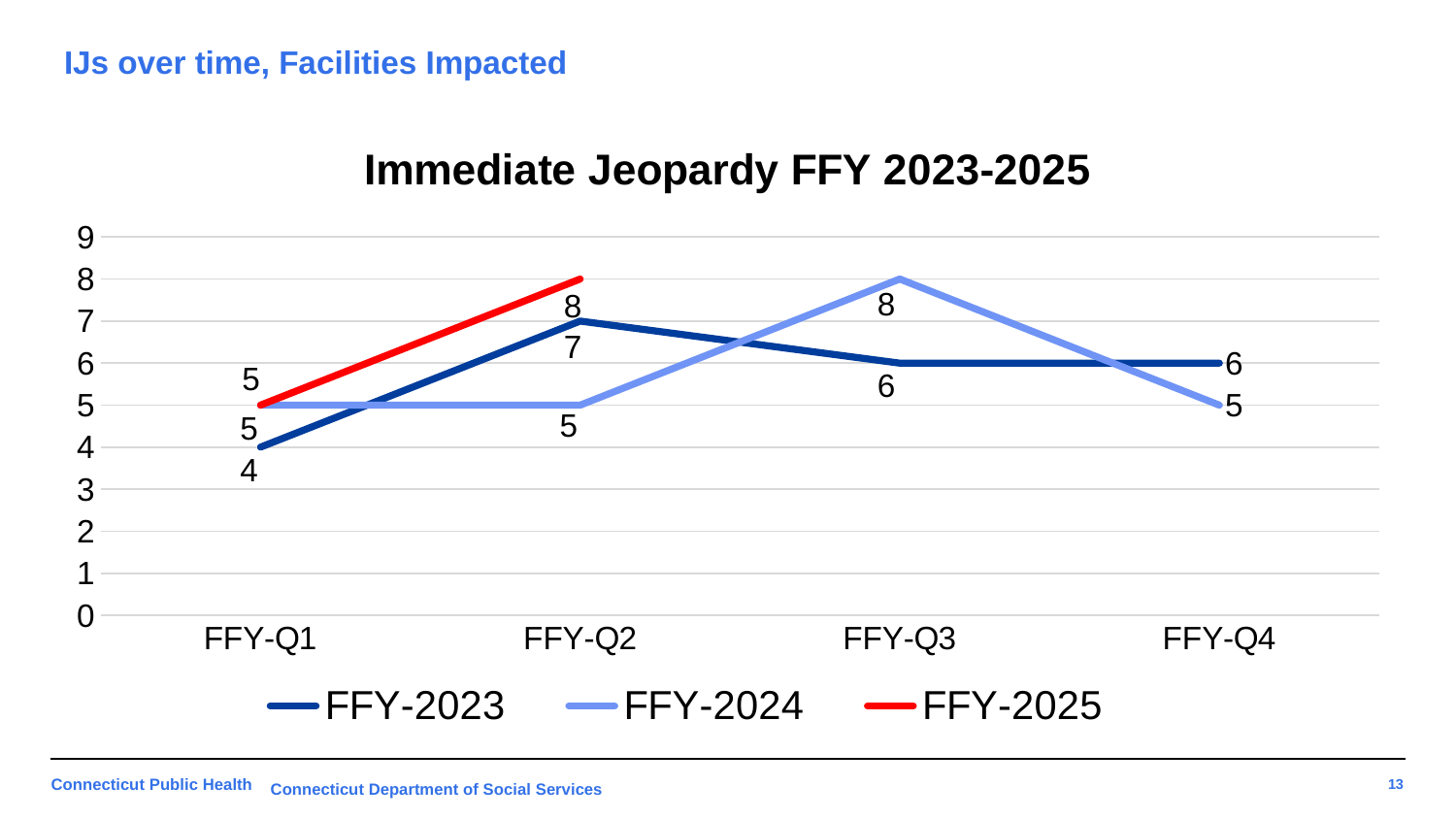
What is the value for FFY-2025 in FFY-Q2? 8 What is the difference between the FFY-2024 values in FFY-Q3 and FFY-Q2? 3 How many quarters are shown on the x axis? 4 What is the value for FFY-2023 in FFY-Q2? 7 What is the value for FFY-2024 in FFY-Q3? 8 Does the FFY-2025 line rise or fall from FFY-Q1 to FFY-Q2? Rise What is the title of the chart? Immediate Jeopardy FFY 2023-2025 In which quarter does FFY-2023 reach its highest value? FFY-Q2 What kind of chart is shown on the slide? Line chart In FFY-Q4, which series has the larger value, FFY-2023 or FFY-2024? FFY-2023 In which quarter does FFY-2023 have its lowest value? FFY-Q1 How many series does the legend list? 3